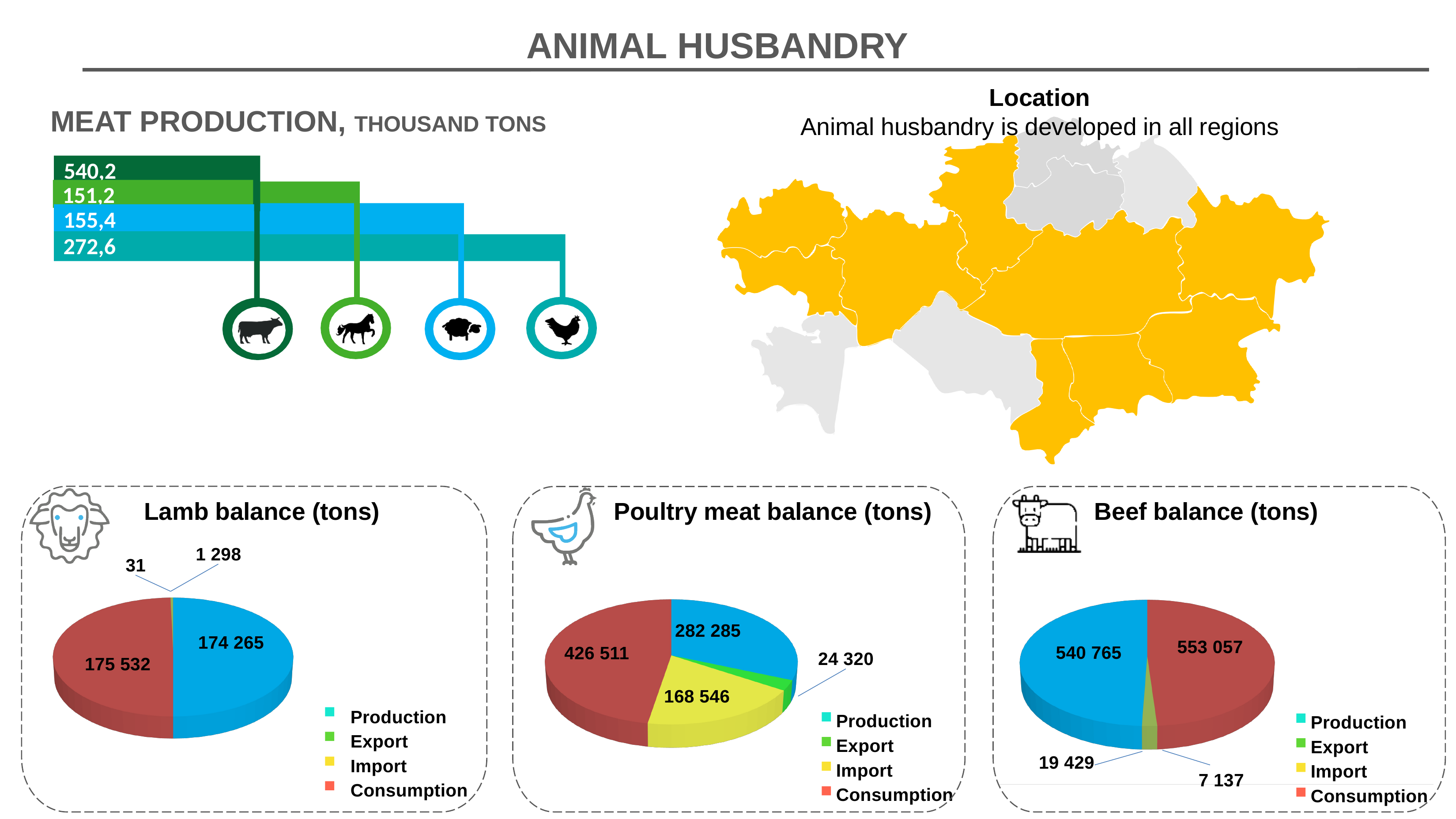
In the Poultry meat balance (tons) pie chart, which category has the largest slice? Consumption How many entries does the legend of the Beef balance (tons) pie chart list? 4 In the Lamb balance (tons) pie chart, what is the value for Consumption? 175 532 In the Meat production, thousand tons chart, what is the value of the top bar (cattle icon)? 540,2 In the Meat production, thousand tons chart, what is the value of the bottom bar (poultry icon)? 272,6 In the Meat production, thousand tons chart, what is the difference between the top bar (540,2) and the bottom bar (272,6)? 267,6 In the Beef balance (tons) pie chart, which is larger, Production or Consumption? Consumption In the Poultry meat balance (tons) pie chart, what is the value for Import? 168 546 What kind of chart is the Meat production, thousand tons chart? bar chart In the Lamb balance (tons) pie chart, what is the value for Production? 174 265 How many bars are in the Meat production, thousand tons chart? 4 In the Poultry meat balance (tons) pie chart, what is the value for Consumption? 426 511